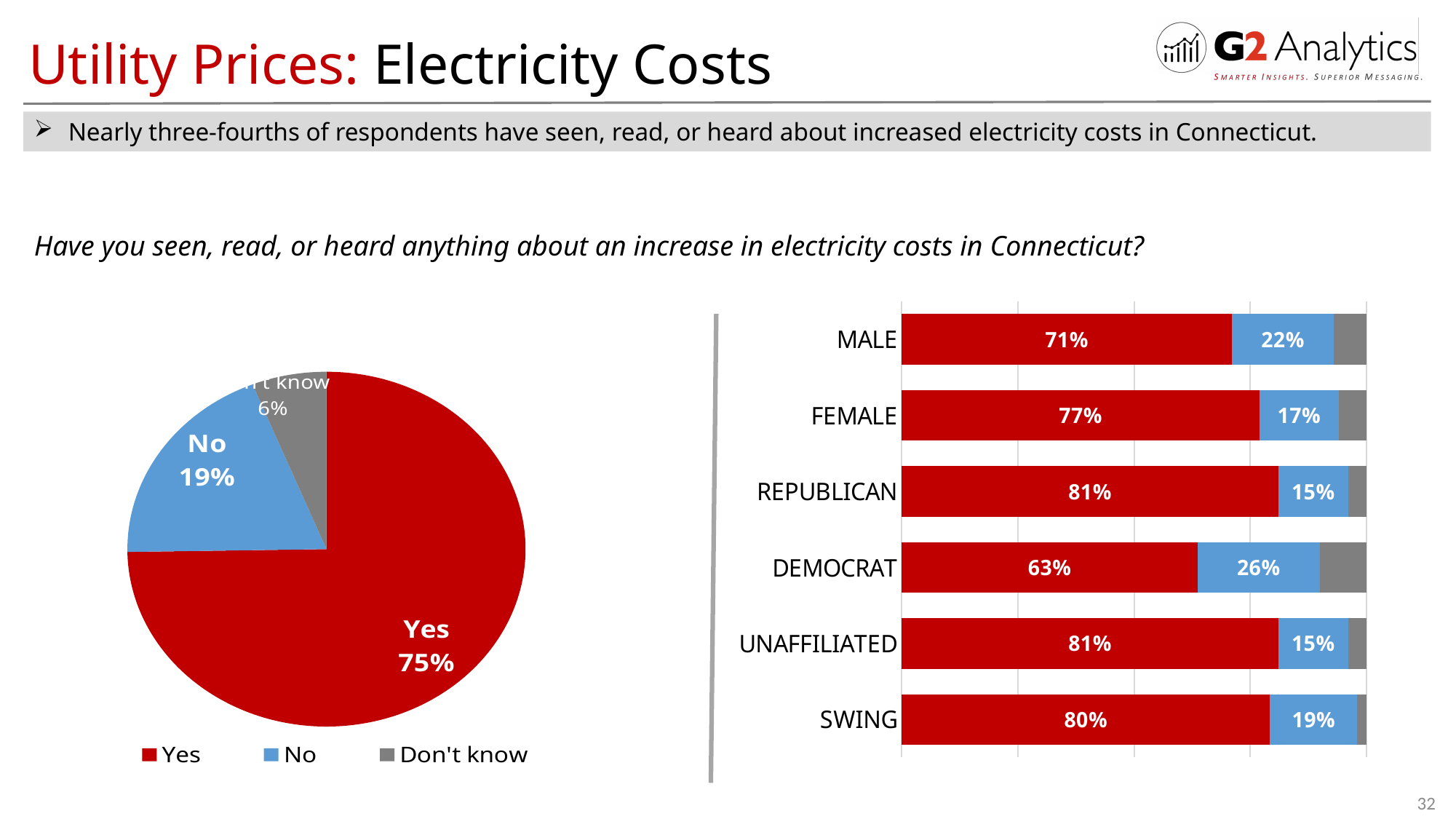
What kind of chart is on the right side of the slide? Stacked bar chart In the bar chart on the right, which group has the lowest red (Yes) value? DEMOCRAT In the bar chart on the right, what is the red (Yes) value for DEMOCRAT? 63% In the pie chart on the left, what share of respondents answered No? 19% In the pie chart on the left, what share of respondents answered Yes? 75% In the bar chart on the right, what is the blue (No) value for MALE? 22% How many groups are shown in the bar chart on the right? 6 How many entries does the legend of the pie chart on the left list? 3 In the bar chart on the right, what is the difference between the red (Yes) values for FEMALE and MALE? 6% In the pie chart on the left, which response has the largest slice? Yes In the pie chart on the left, what share of respondents answered Don't know? 6% In the bar chart on the right, which is larger: the blue (No) value for DEMOCRAT or for REPUBLICAN? DEMOCRAT